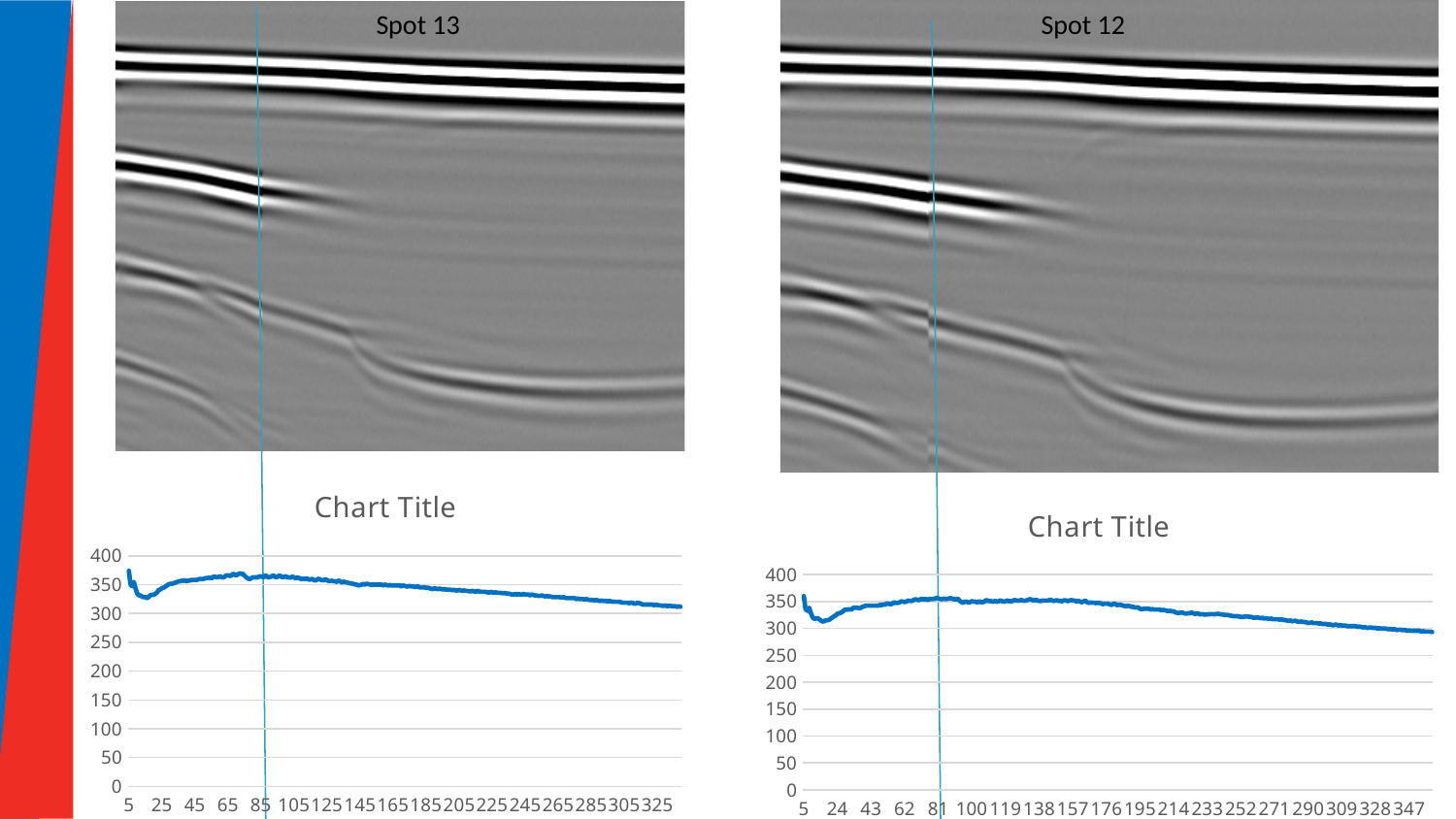
In the left chart (below Spot 13), is the value at x = 325 greater or less than 350? less What kind of chart is the left chart (below Spot 13)? line chart In the right chart (below Spot 12), which is larger: the value at x = 138 or the value at x = 347? x = 138 In the left chart (below Spot 13), which is larger: the value at x = 125 or the value at x = 325? x = 125 What kind of chart is the right chart (below Spot 12)? line chart What is the title shown on the left chart (below Spot 13)? Chart Title In the left chart (below Spot 13), does the line rise or fall from x = 145 to x = 325? fall In the right chart (below Spot 12), is the value at x = 5 greater or less than 300? greater What is the highest value labelled on the vertical axis of the right chart (below Spot 12)? 400 In the right chart (below Spot 12), is the value at x = 138 greater or less than 300? greater